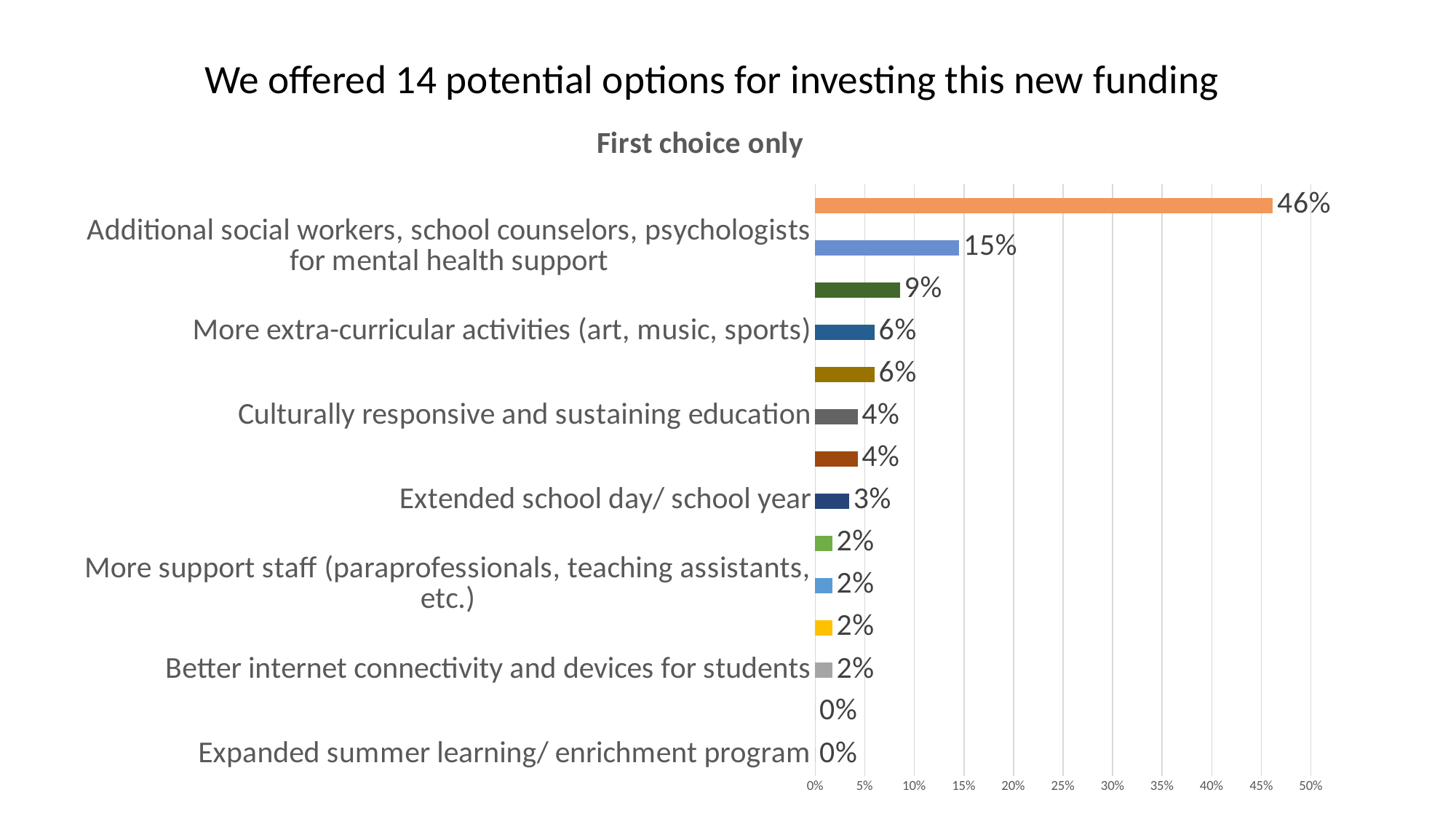
What is the difference between the second-highest value (15%) and the third-highest value (9%)? 6% What is the title of the chart? First choice only What kind of chart is shown on the slide? bar chart What is the highest value shown in the chart? 46% How many bars are plotted in the chart? 14 What is the value for 'Culturally responsive and sustaining education'? 4% Is the value of the longest bar greater or less than 45%? greater What is the value for 'Better internet connectivity and devices for students'? 2% What is the value for 'Extended school day/ school year'? 3% What is the lowest value shown in the chart? 0% What is the value for 'More extra-curricular activities (art, music, sports)'? 6% What is the value for 'Expanded summer learning/ enrichment program'? 0%